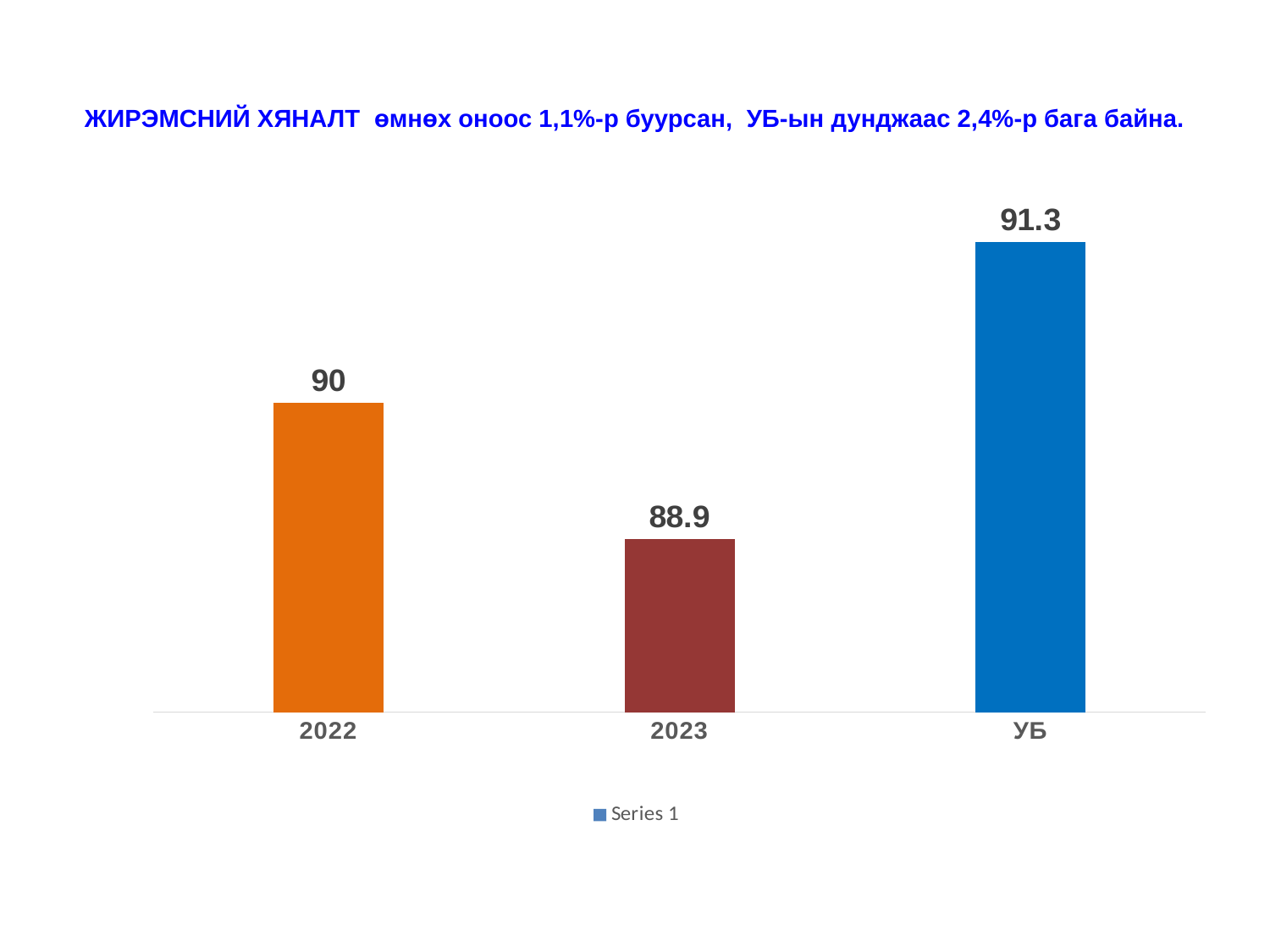
What is the value for УБ? 91.3 What is the difference between the values for 2022 and 2023? 1.1 What kind of chart is shown on the slide? bar chart What is the legend entry shown below the chart? Series 1 Which category has the lowest value? 2023 Which is larger, the value for 2022 or the value for УБ? УБ What is the value for 2023? 88.9 What is the value for 2022? 90 What is the difference between the values for УБ and 2023? 2.4 How many series does the legend list? 1 Which category has the highest value? УБ How many categories are shown on the x axis? 3